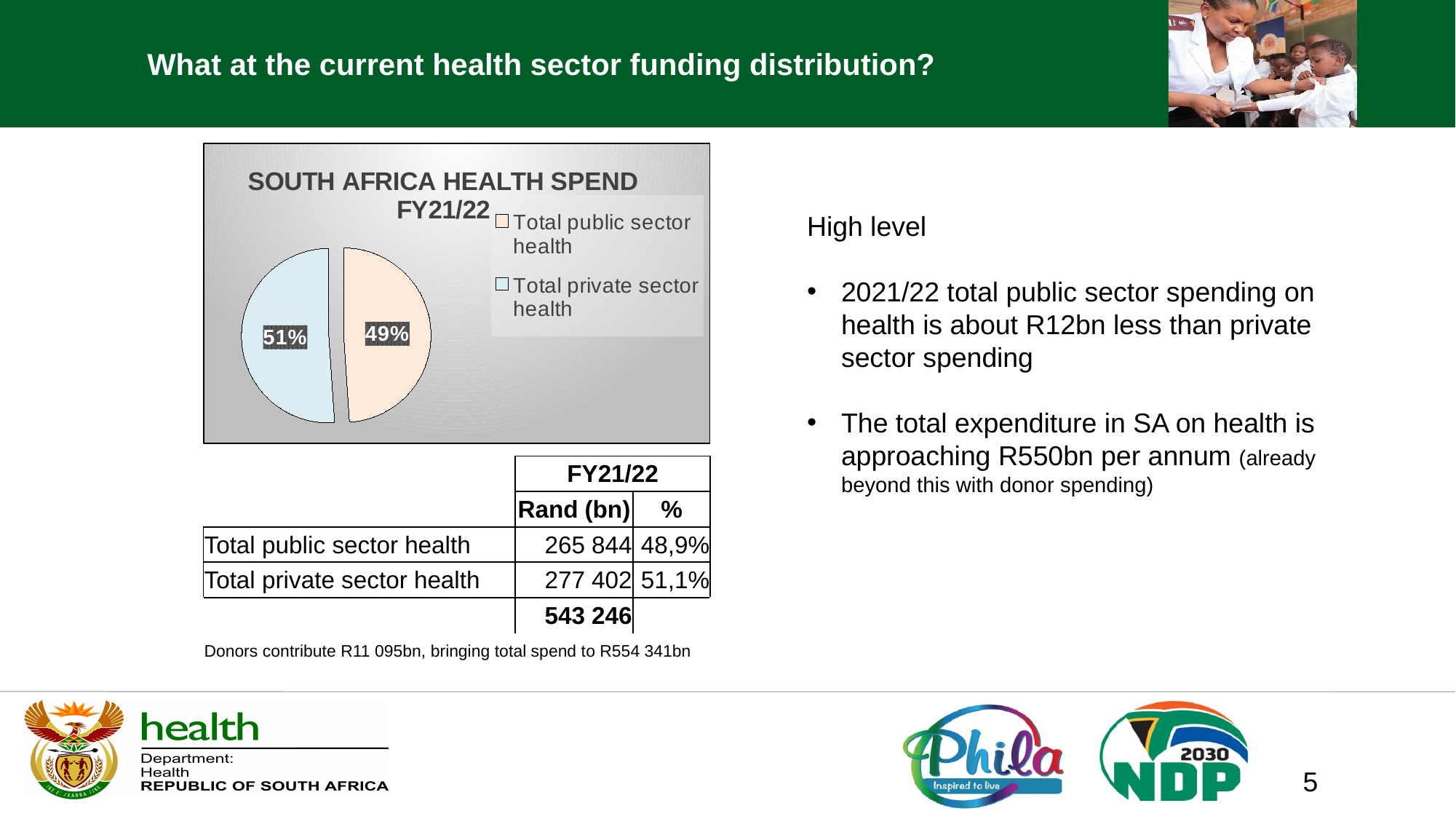
What percentage of the pie is labelled for Total private sector health? 51% What percentage of the pie is labelled for Total public sector health? 49% How many slices does the pie chart have? 2 Which slice of the pie is the smallest? Total public sector health By how many percentage points does the Total private sector health slice exceed the Total public sector health slice? 2 percentage points How many entries does the chart legend list? 2 What type of chart is shown on the slide? Pie chart Which is larger in the pie chart: Total public sector health or Total private sector health? Total private sector health Which legend entry is shown in light blue? Total private sector health What is the title of the chart? SOUTH AFRICA HEALTH SPEND FY21/22 Which slice of the pie is the largest? Total private sector health What share of the pie does Total private sector health represent? 51%